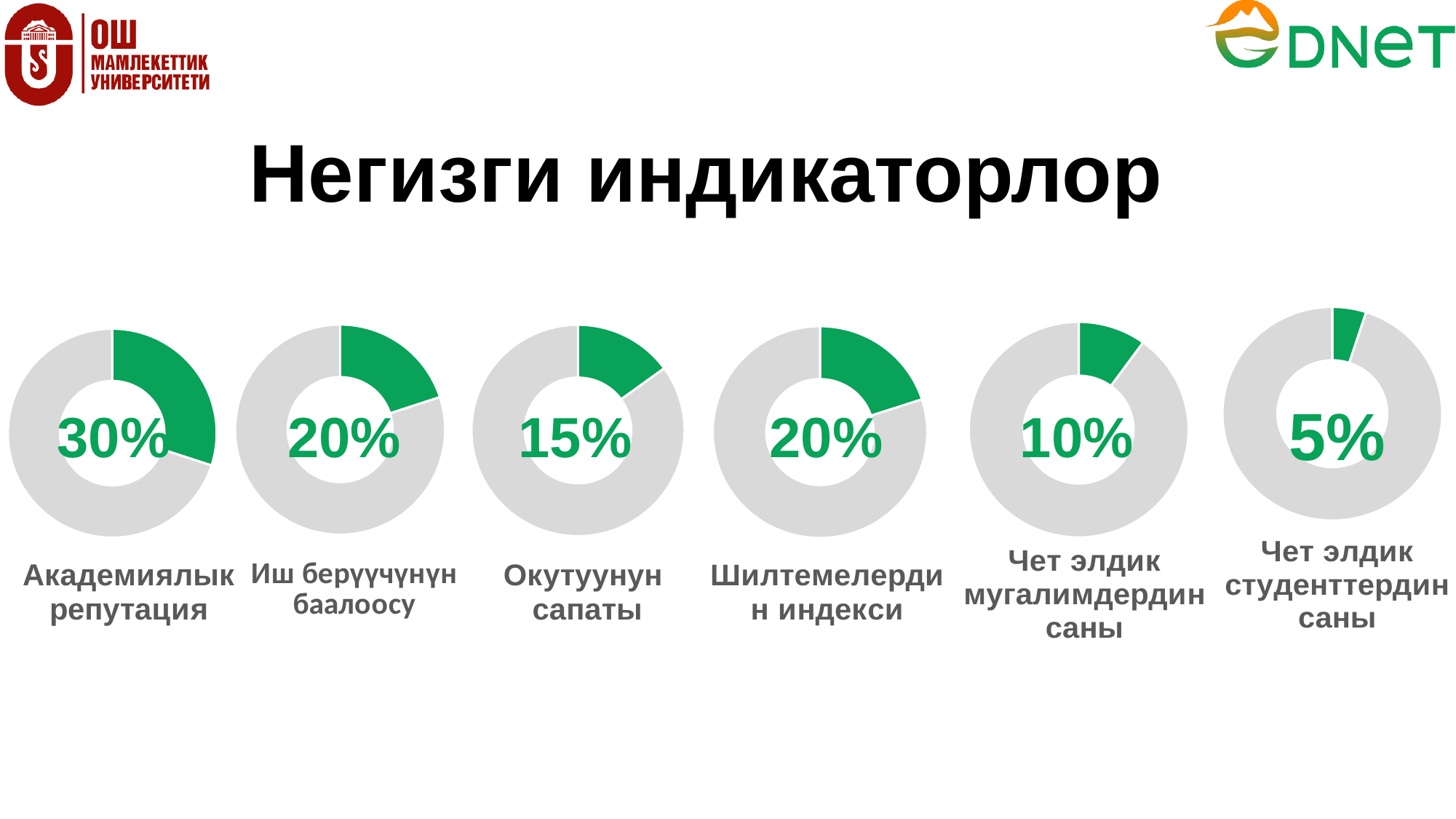
What type of chart is used for each indicator on the slide? Donut chart How many donut charts are shown on the slide? 6 Across the six donut charts on the slide, which indicator has the highest percentage? Академиялык репутация In the donut chart labelled "Чет элдик студенттердин саны", what percentage is shown? 5% In the donut chart labelled "Чет элдик мугалимдердин саны", what percentage is shown? 10% In the donut chart labelled "Окутуунун сапаты", what percentage is shown? 15% In the donut chart labelled "Шилтемелердин индекси", what percentage is shown? 20% Across the six donut charts on the slide, which indicator has the lowest percentage? Чет элдик студенттердин саны In the donut chart labelled "Иш берүүчүнүн баалоосу", what percentage is shown? 20% Which is larger: the percentage in the "Чет элдик мугалимдердин саны" chart or the percentage in the "Чет элдик студенттердин саны" chart? Чет элдик мугалимдердин саны What is the difference between the percentage in the "Академиялык репутация" chart and the percentage in the "Окутуунун сапаты" chart? 15% In the donut chart labelled "Академиялык репутация", what percentage is shown? 30%